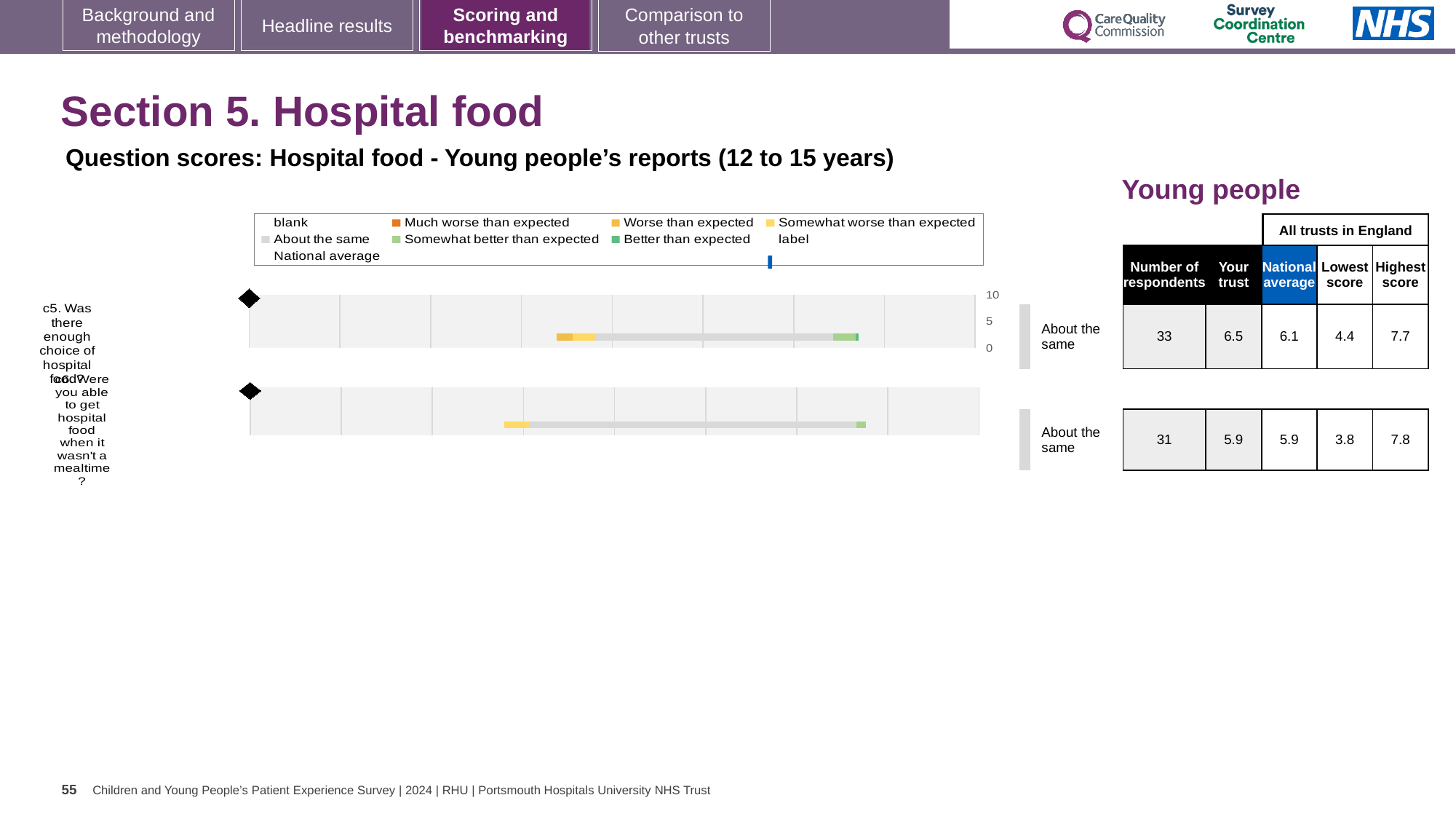
What kind of chart is used to show the question scores for hospital food? bar chart What benchmark category is shown for question c6? About the same What is the 'Your trust' score for question c5 (Was there enough choice of hospital food?)? 6.5 How many respondents answered question c5? 33 What is the national average score for question c6 (Were you able to get hospital food when it wasn't a mealtime?)? 5.9 How many questions (categories) are plotted in the hospital food chart? 2 Which question has the higher 'Your trust' score, c5 or c6? c5 Is the 'Your trust' score for question c6 greater or less than 5? greater By how much does the trust's score for c5 exceed the national average? 0.4 What does the blue marker in the chart legend represent? National average What is the lowest score across all trusts in England for question c6? 3.8 What is the difference between the highest and lowest scores for question c5? 3.3